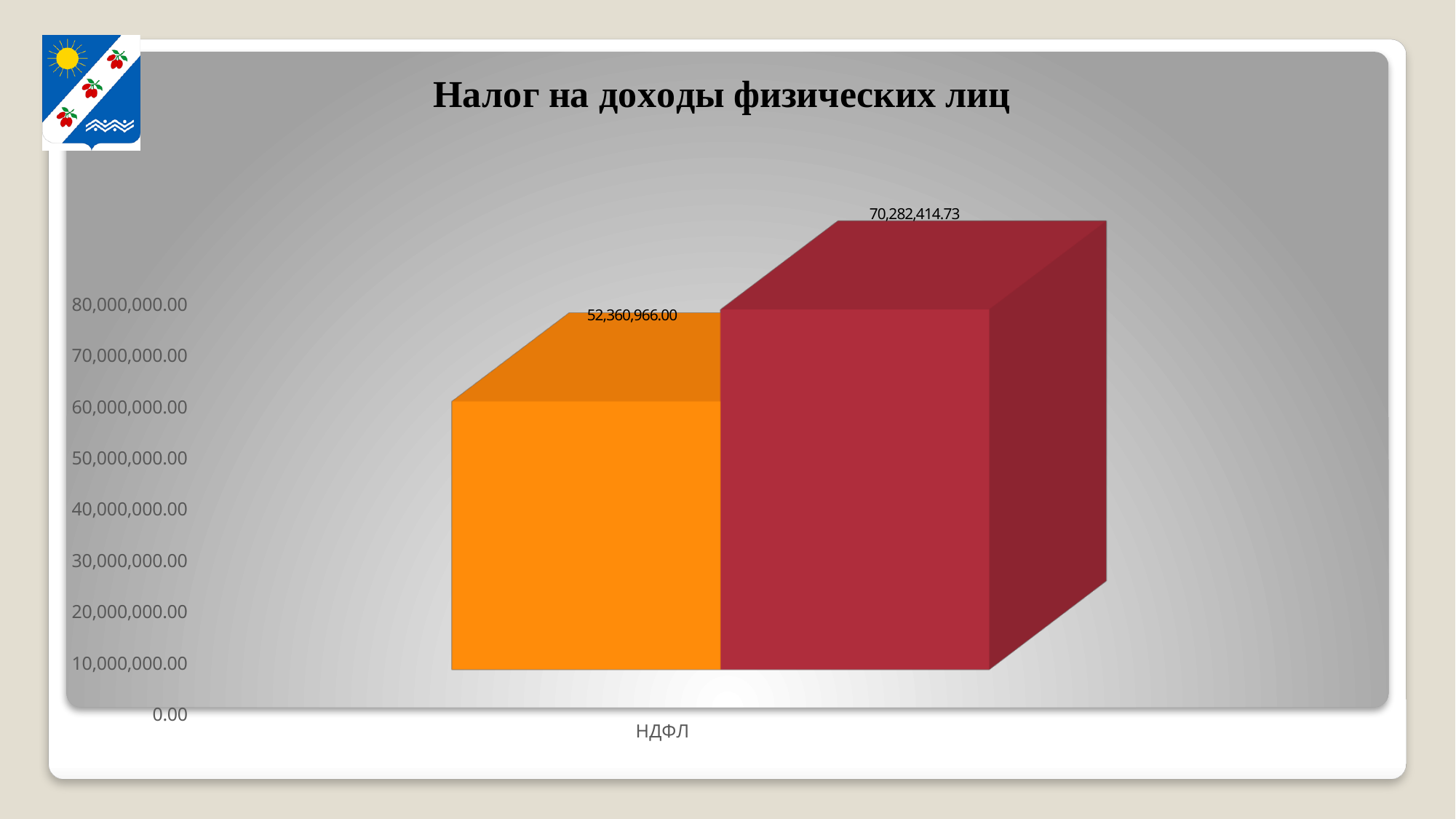
How many bars are plotted in the chart? 2 What kind of chart is shown on the slide? bar chart Which bar is taller, the orange bar or the red bar? the red bar What is the value shown on the red bar in the chart? 70,282,414.73 Is the value of the orange bar greater or less than 50,000,000.00? greater What is the value shown on the orange bar in the chart? 52,360,966.00 What is the difference between the red bar's value and the orange bar's value? 17,921,448.73 Which bar has the highest value in the chart? the red bar (70,282,414.73) Is the value of the red bar greater or less than 80,000,000.00? less What is the title of the chart? Налог на доходы физических лиц How many categories are shown on the x axis of the chart? 1 Which bar has the lowest value in the chart? the orange bar (52,360,966.00)